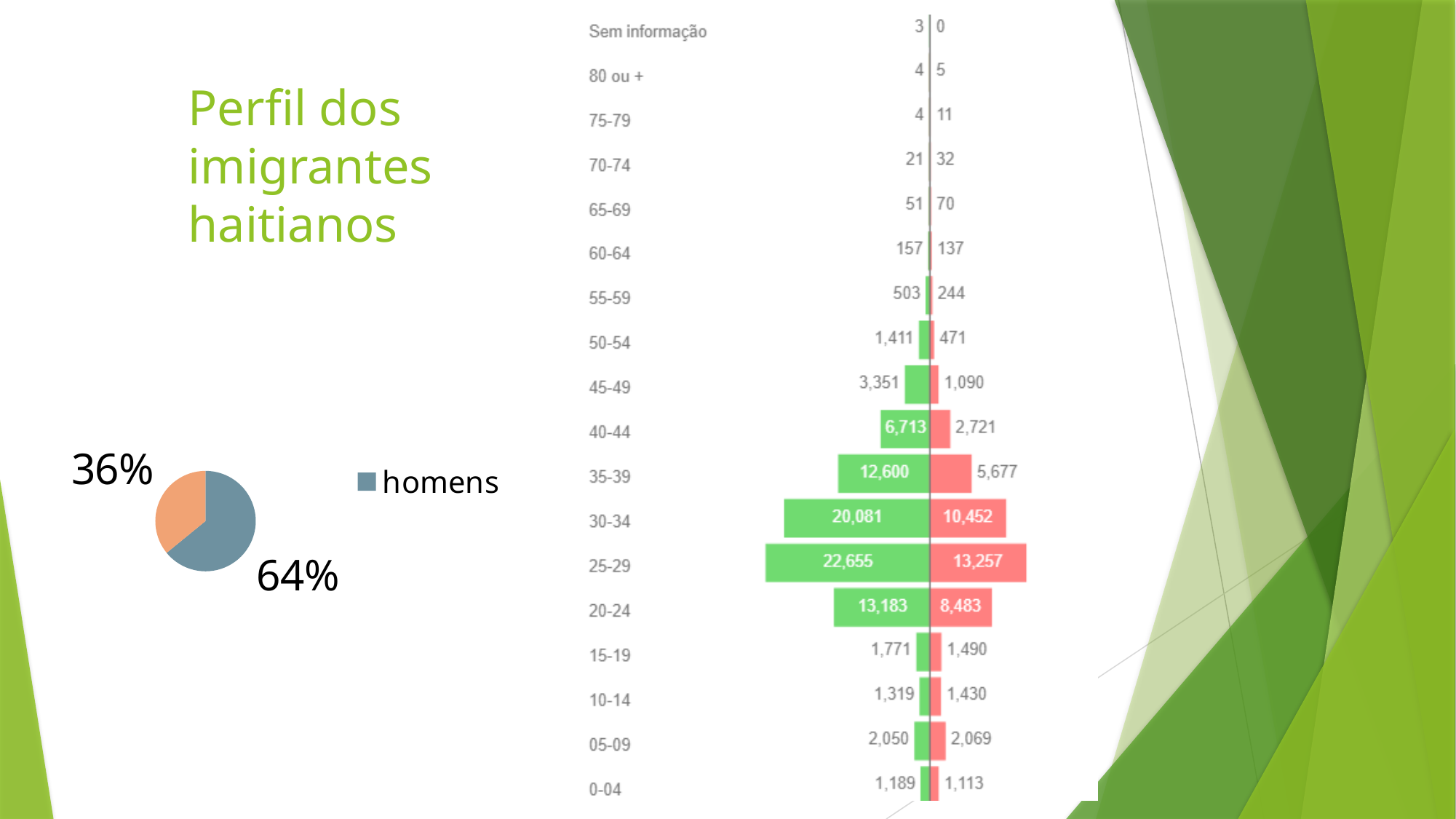
In the age pyramid chart on the right, what is the red (right-side) value for the 30-34 age group? 10,452 What kind of chart is the chart on the left of the slide? pie chart In the age pyramid chart on the right, which age group has the highest green (left-side) value? 25-29 In the pie chart on the left, what share of the pie does the 'homens' slice represent? 64% In the age pyramid chart on the right, what is the difference between the green and red values for the 25-29 age group? 9,398 In the pie chart on the left, what percentage is shown for the orange slice? 36% In the age pyramid chart on the right, what is the total of the green and red values for the 20-24 age group? 21,666 In the age pyramid chart on the right, for the 35-39 age group, which is larger: the green value or the red value? green In the age pyramid chart on the right, what is the red (right-side) value for the 60-64 age group? 137 What kind of chart is the age pyramid chart on the right of the slide? bar chart In the age pyramid chart on the right, what is the green (left-side) value for the 25-29 age group? 22,655